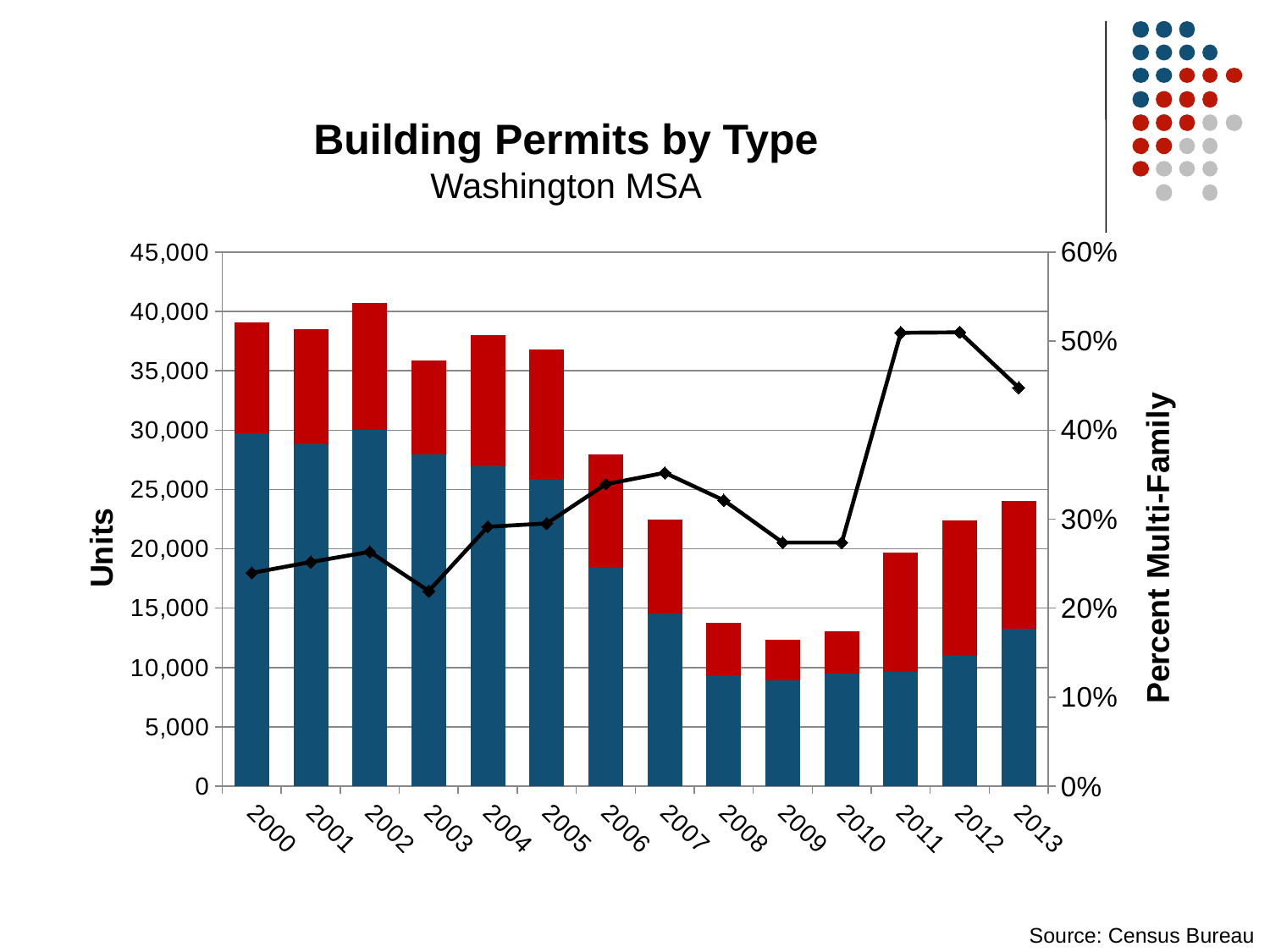
Which year has the lowest point on the Percent Multi-Family line? 2003 What is the label on the right-hand vertical axis? Percent Multi-Family Which year has the tallest total bar (most units)? 2002 Which year has the shortest total bar (fewest units)? 2009 Do the total bar heights rise or fall from 2005 to 2009? fall How many years are shown on the x axis of the chart? 14 Is the Percent Multi-Family value for 2007 greater or less than 30%? greater What kind of chart is shown on the slide? A stacked bar chart with a line Is the Percent Multi-Family value for 2013 greater or less than 50%? less Is the total units value for 2009 greater or less than 15,000? less Which year has a taller total bar, 2006 or 2007? 2006